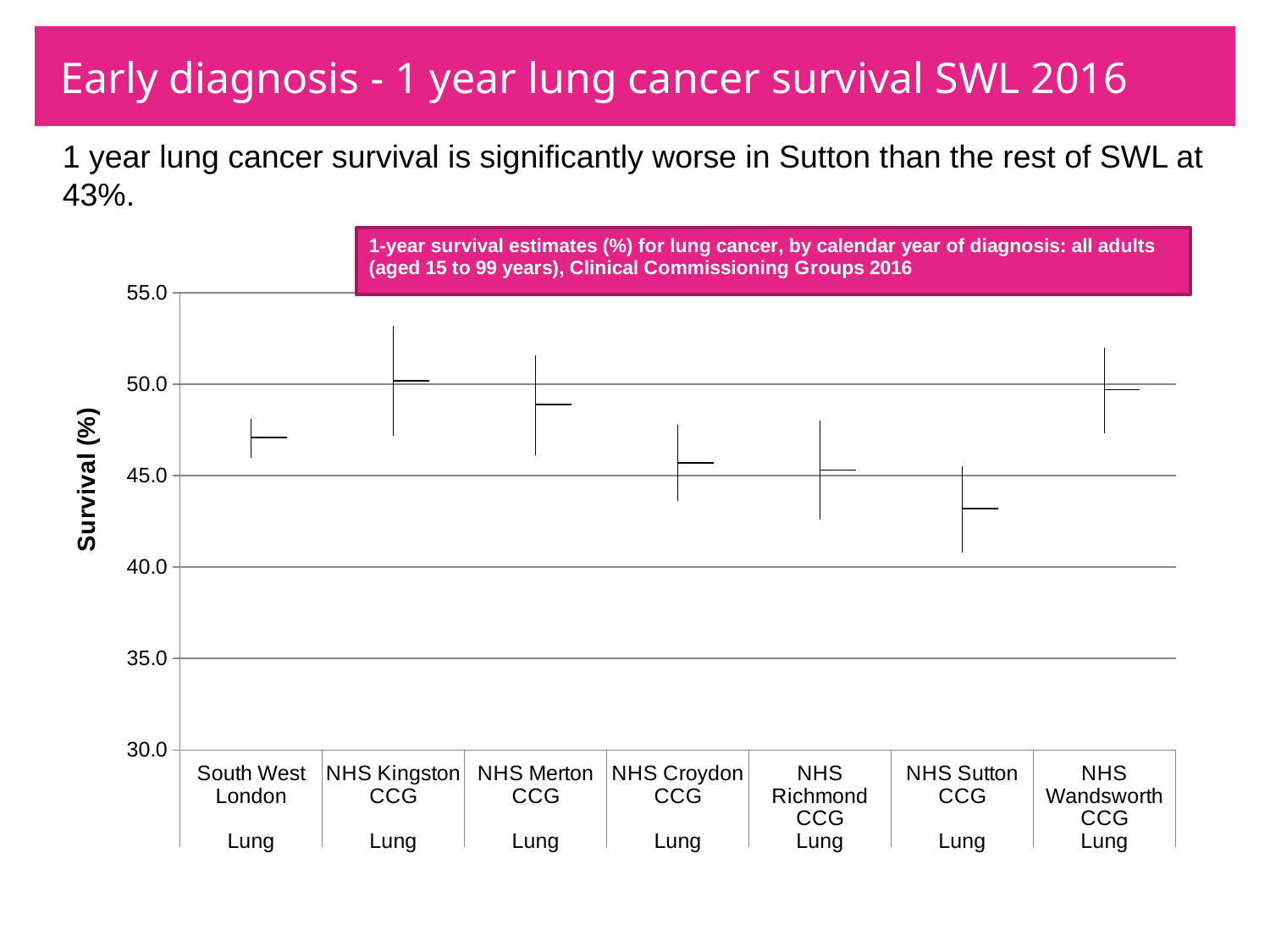
What is the highest value shown on the vertical axis? 55.0 Is the survival estimate for NHS Sutton CCG greater or less than 40.0? greater What is the label of the vertical axis? Survival (%) Is the survival estimate for NHS Merton CCG greater or less than 50.0? less Which CCG has the lowest 1-year lung cancer survival estimate on the chart? NHS Sutton CCG Which has the higher survival estimate, NHS Wandsworth CCG or NHS Richmond CCG? NHS Wandsworth CCG Which has the higher survival estimate, NHS Kingston CCG or NHS Sutton CCG? NHS Kingston CCG How many areas (categories) are plotted on the chart? 7 Is the survival estimate for NHS Sutton CCG greater or less than 45.0? less Which has the higher survival estimate, NHS Merton CCG or NHS Croydon CCG? NHS Merton CCG